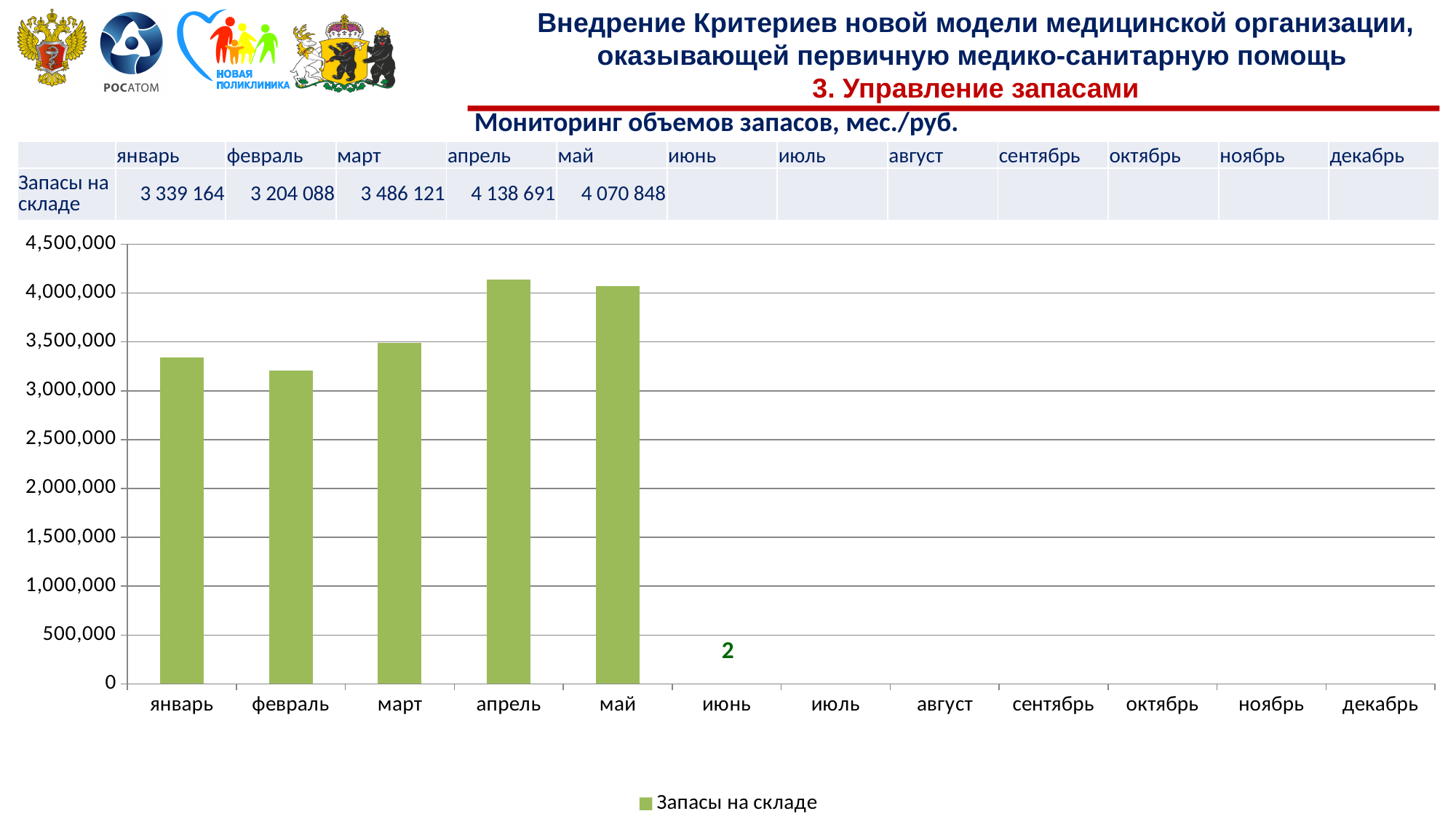
Which month has the lowest value among the months with data? февраль Is the value for январь greater or less than 3,500,000? less What is the value for апрель in the chart? 4 138 691 How many series does the legend list? 1 Which month has the highest value in the chart? апрель Which is larger, the value for январь or the value for февраль? январь What is the value for май in the chart? 4 070 848 What is the difference between the values for март and февраль? 282 033 What is the value for февраль in the chart? 3 204 088 What kind of chart is shown on the slide? bar chart How many months have bars plotted in the chart? 5 What is the difference between the values for апрель and май? 67 843